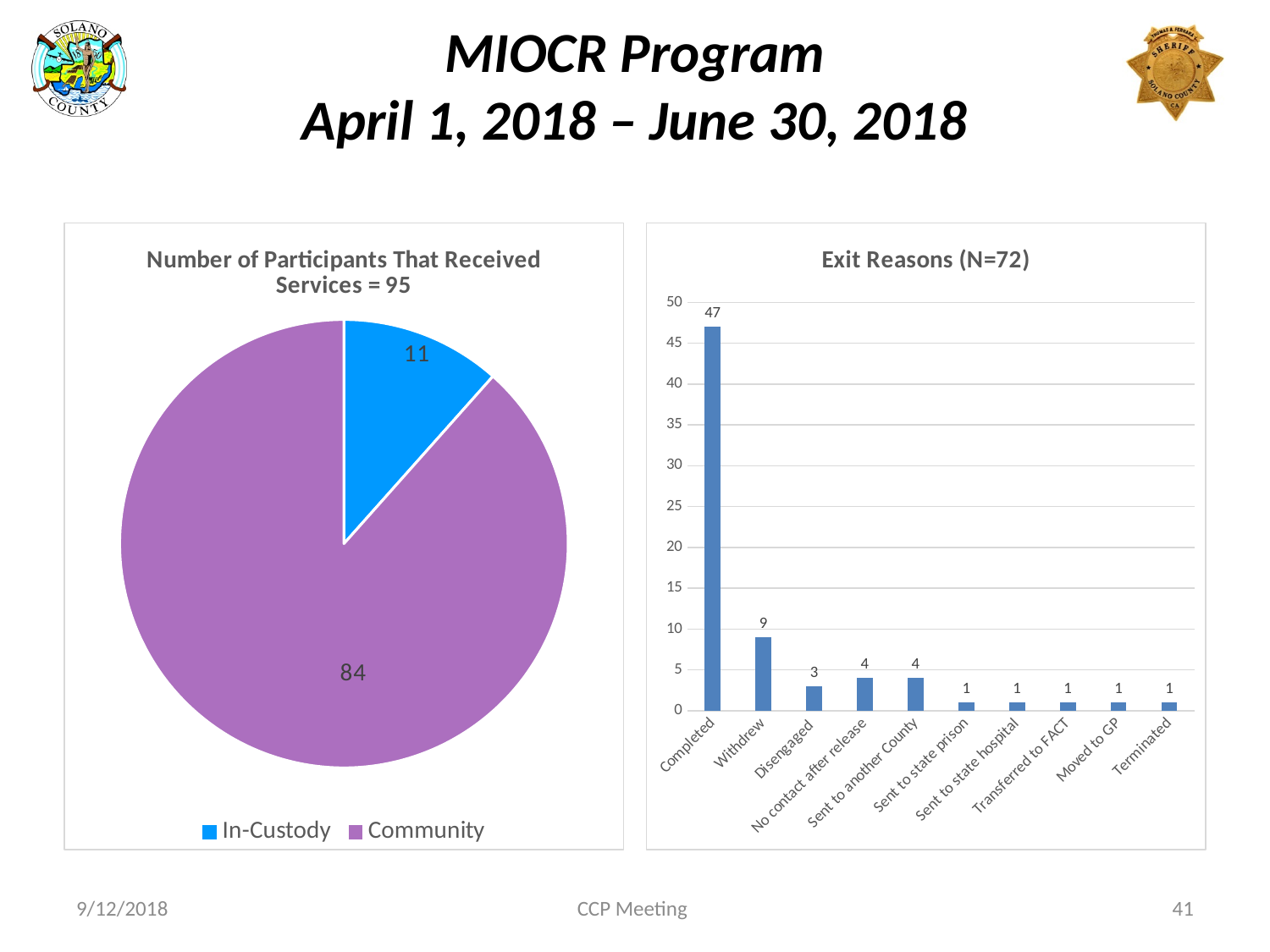
In the 'Number of Participants That Received Services = 95' pie chart, what is the value for Community? 84 In the 'Exit Reasons (N=72)' chart, how many exit reason categories are shown? 10 In the 'Number of Participants That Received Services = 95' pie chart, how many slices are there? 2 In the 'Number of Participants That Received Services = 95' pie chart, what is the difference between the Community and In-Custody values? 73 In the 'Number of Participants That Received Services = 95' pie chart, what is the value for In-Custody? 11 In the 'Exit Reasons (N=72)' chart, which exit reason has the highest value? Completed What kind of chart is the 'Number of Participants That Received Services = 95' chart? Pie chart In the 'Exit Reasons (N=72)' chart, what is the value for Completed? 47 What kind of chart is the 'Exit Reasons (N=72)' chart? Bar chart In the 'Exit Reasons (N=72)' chart, what is the value for Withdrew? 9 In the 'Exit Reasons (N=72)' chart, what is the difference between Completed and Withdrew? 38 In the 'Exit Reasons (N=72)' chart, which is larger, Disengaged or No contact after release? No contact after release